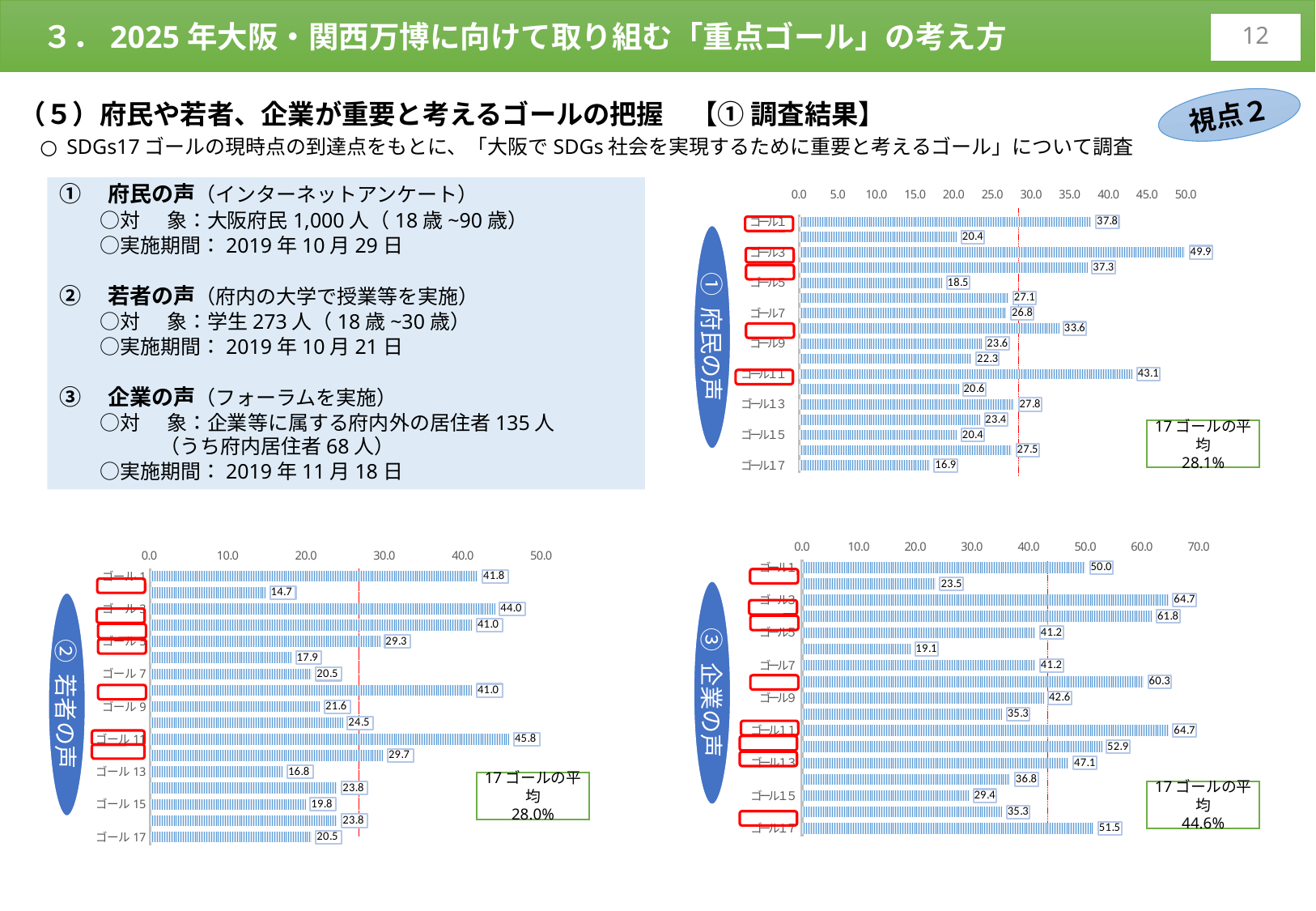
In the 企業の声 chart, what is the value for ゴール17? 51.5 In the 府民の声 chart, what is the difference between the values for ゴール11 and ゴール13? 15.3 In the 若者の声 chart, which goal has the highest value? ゴール11 In the 企業の声 chart, is the value for ゴール15 greater or less than 30.0? less In the 若者の声 chart, what is the value for ゴール11? 45.8 In the 若者の声 chart, which is larger, the value for ゴール7 or the value for ゴール9? ゴール9 In the 府民の声 chart, which goal has the highest value? ゴール3 In the 府民の声 chart, which goal has the lowest value? ゴール17 What type of chart is the 企業の声 chart? bar chart In the 企業の声 chart, what is the value for ゴール13? 47.1 What is the 17-goal average shown for the 企業の声 chart? 44.6% In the 府民の声 chart, what is the value for ゴール17? 16.9